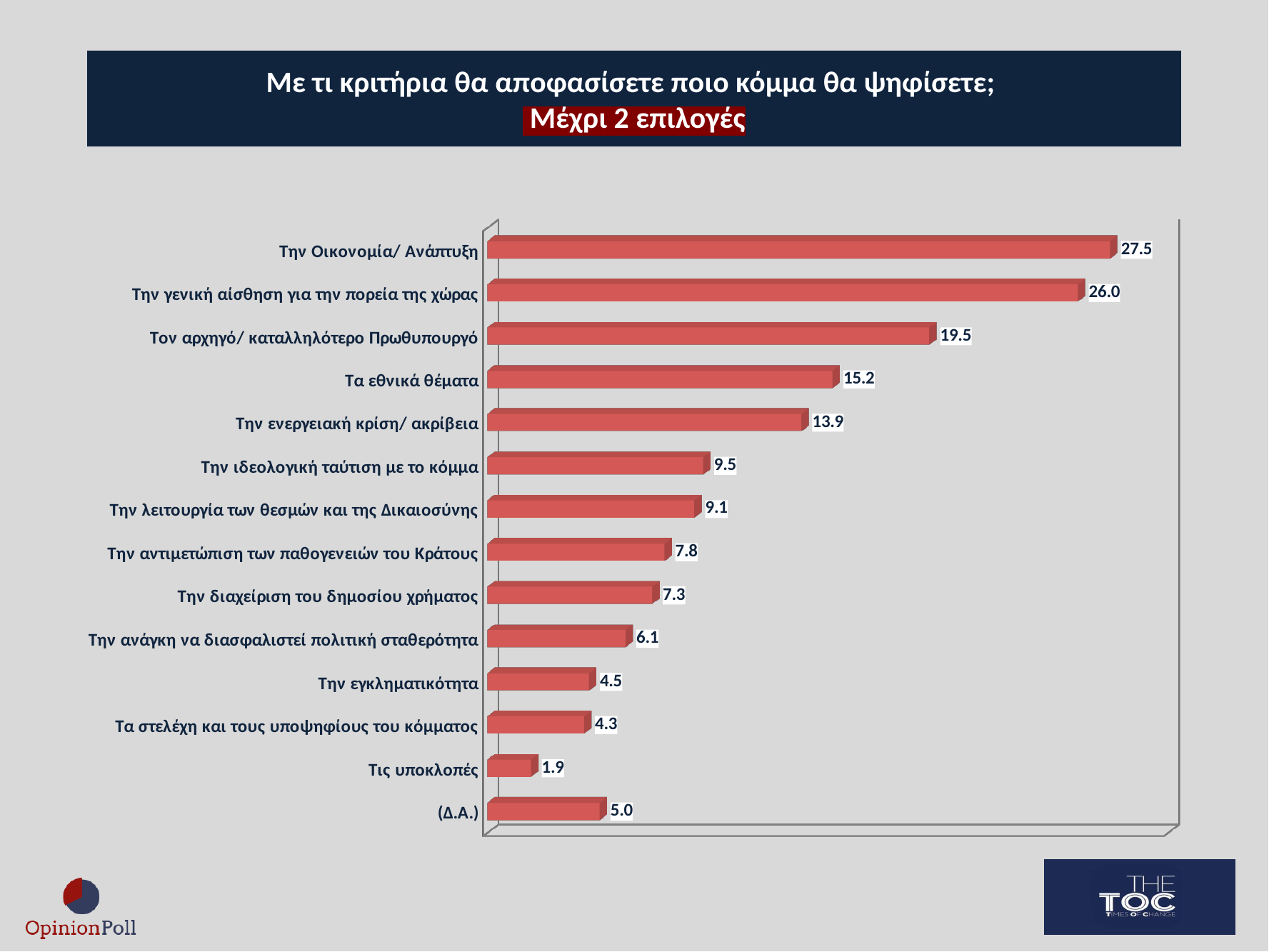
What is the difference between the values for Την Οικονομία/ Ανάπτυξη and Την γενική αίσθηση για την πορεία της χώρας? 1.5 Which category has the lowest value? Τις υποκλοπές What is the subtitle shown in the red box under the chart title? Μέχρι 2 επιλογές Which is larger, the value for Την ιδεολογική ταύτιση με το κόμμα or the value for Την διαχείριση του δημοσίου χρήματος? Την ιδεολογική ταύτιση με το κόμμα What is the value for Τα εθνικά θέματα? 15.2 Which category has the highest value? Την Οικονομία/ Ανάπτυξη What is the value for (Δ.Α.)? 5.0 What is the difference between the values for Τον αρχηγό/ καταλληλότερο Πρωθυπουργό and Την ενεργειακή κρίση/ ακρίβεια? 5.6 What kind of chart is shown on the slide? Bar chart What is the value for Την εγκληματικότητα? 4.5 What is the value for Την Οικονομία/ Ανάπτυξη? 27.5 How many categories are shown in the chart? 14